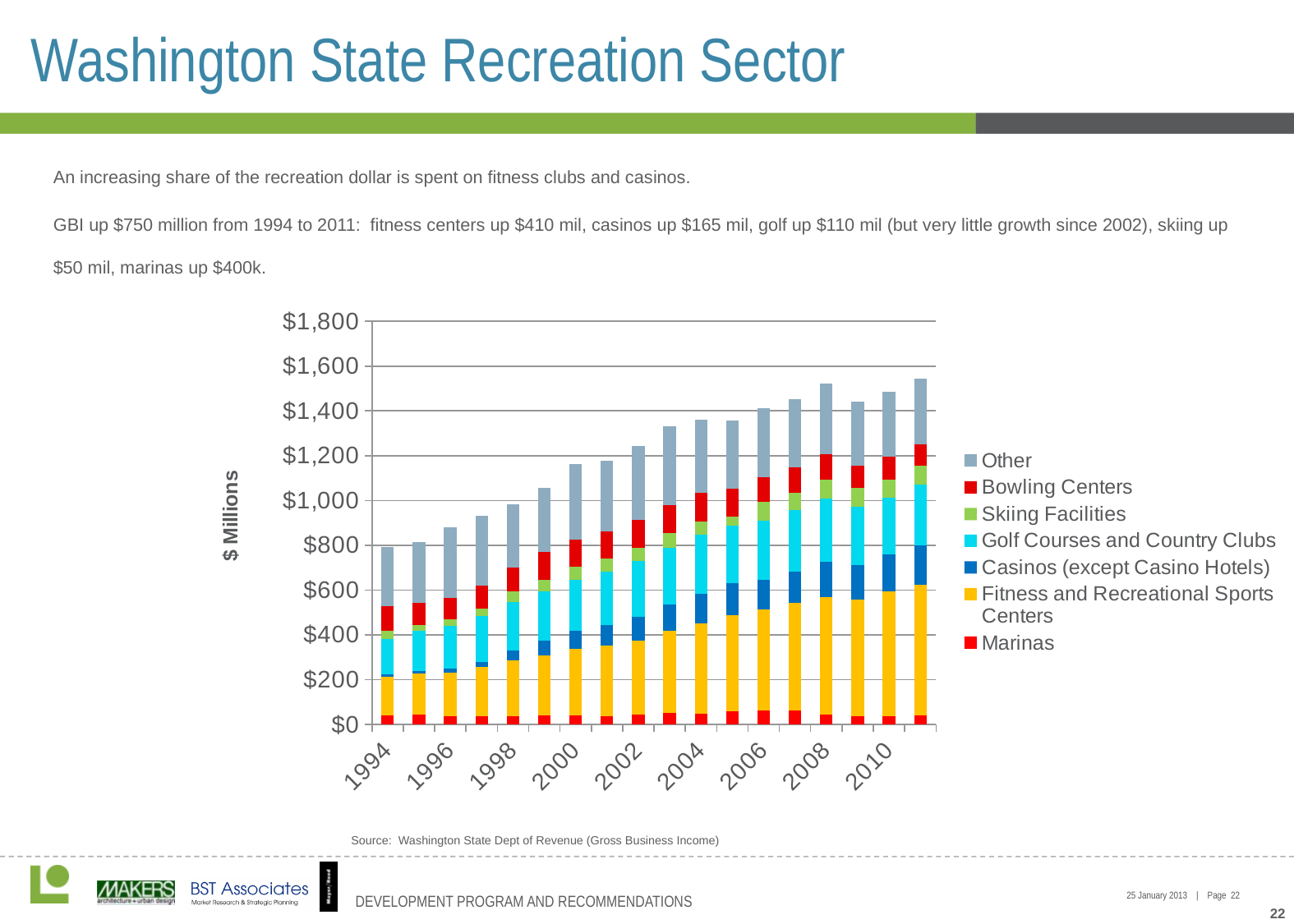
Is the total value of the bar for 2004 greater or less than $1,200? greater Which series forms the largest segment of the 2011 bar? Fitness and Recreational Sports Centers Is the total value of the bar for 2000 greater or less than $1,000? greater What is the label on the chart's vertical axis? $ Millions How many years (bars) are plotted in the chart? 18 Do the total bar values generally rise or fall from 1994 to 2011? rise Which series is listed first (at the top) in the chart's legend? Other How many series does the chart's legend list? 7 Which is larger, the total bar for 2011 or the total bar for 1994? 2011 What kind of chart is shown on the slide? Stacked bar chart Is the total value of the bar for 1996 greater or less than $1,000? less